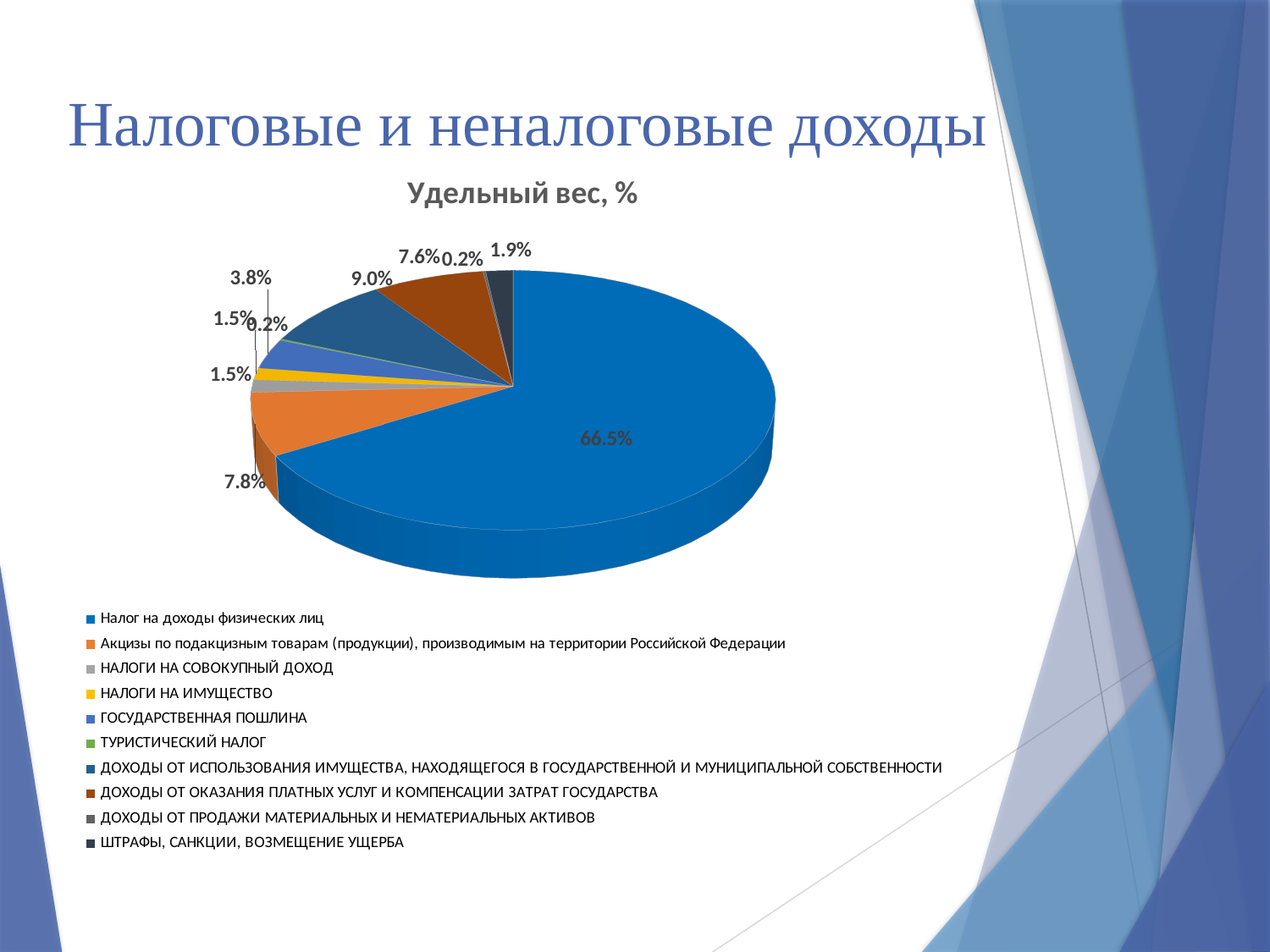
What is the share for Акцизы по подакцизным товарам (продукции), производимым на территории Российской Федерации? 7.8% Which category has the largest share of the pie? Налог на доходы физических лиц What is the share for ДОХОДЫ ОТ ИСПОЛЬЗОВАНИЯ ИМУЩЕСТВА, НАХОДЯЩЕГОСЯ В ГОСУДАРСТВЕННОЙ И МУНИЦИПАЛЬНОЙ СОБСТВЕННОСТИ? 9.0% Which is larger: the share for ДОХОДЫ ОТ ИСПОЛЬЗОВАНИЯ ИМУЩЕСТВА or the share for ДОХОДЫ ОТ ОКАЗАНИЯ ПЛАТНЫХ УСЛУГ? ДОХОДЫ ОТ ИСПОЛЬЗОВАНИЯ ИМУЩЕСТВА What is the share for Налог на доходы физических лиц? 66.5% What is the share for ШТРАФЫ, САНКЦИИ, ВОЗМЕЩЕНИЕ УЩЕРБА? 1.9% What is the title of the chart? Удельный вес, % What is the difference between the share for Налог на доходы физических лиц and the share for Акцизы по подакцизным товарам? 58.7% What kind of chart is shown on the slide? pie chart What is the smallest share value shown on the pie chart? 0.2% What is the share for ДОХОДЫ ОТ ОКАЗАНИЯ ПЛАТНЫХ УСЛУГ И КОМПЕНСАЦИИ ЗАТРАТ ГОСУДАРСТВА? 7.6% How many categories does the pie chart's legend list? 10